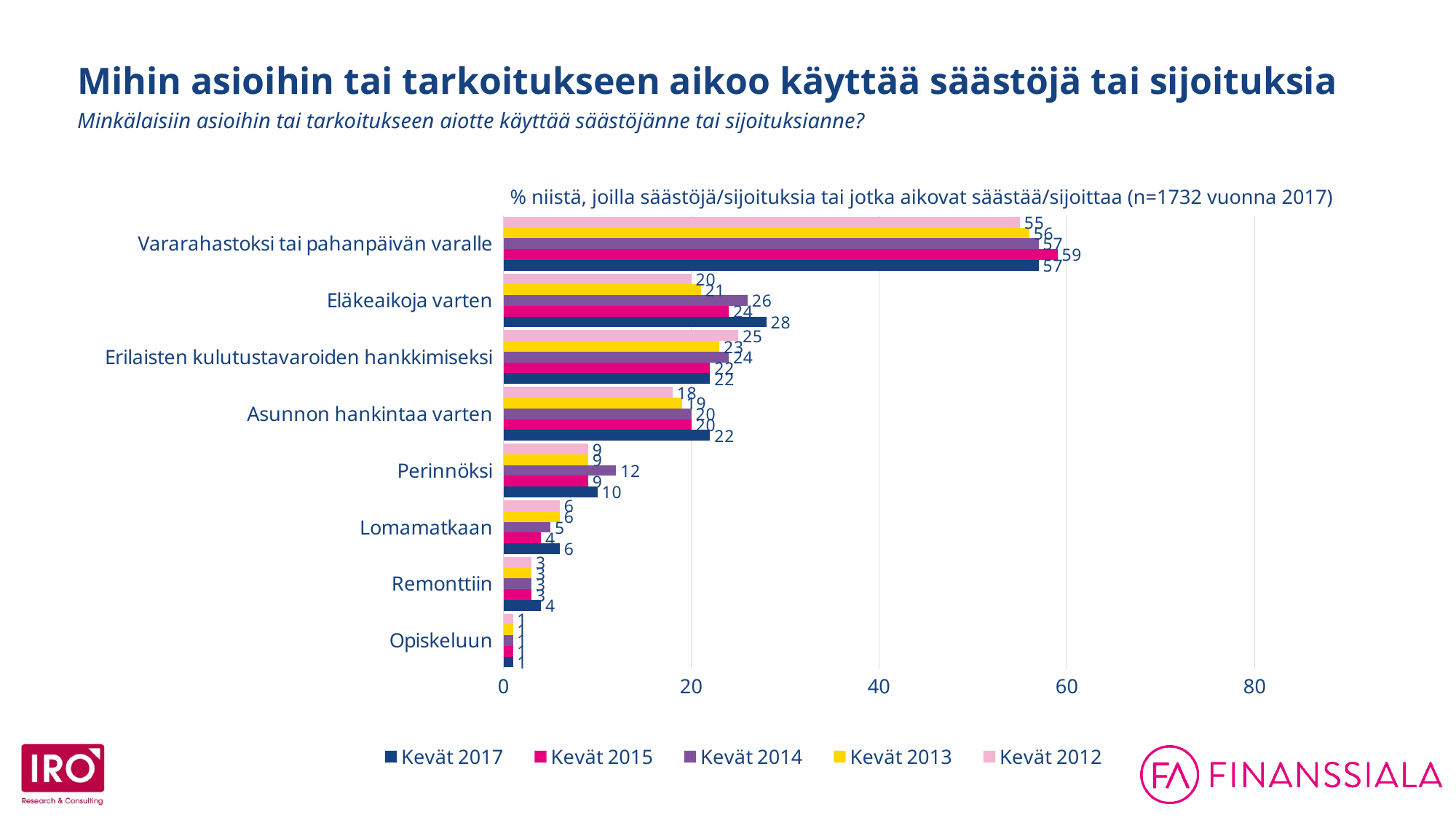
For 'Erilaisten kulutustavaroiden hankkimiseksi', which is larger: the Kevät 2012 value or the Kevät 2017 value? Kevät 2012 Which category has the lowest value in the Kevät 2017 series? Opiskeluun Which series is shown in yellow in the legend? Kevät 2013 Which category has the highest value in the Kevät 2017 series? Vararahastoksi tai pahanpäivän varalle What is the value for 'Perinnöksi' in the Kevät 2014 series? 12 Is the Kevät 2015 value for 'Vararahastoksi tai pahanpäivän varalle' greater or less than 40? greater How many series does the legend list? 5 What kind of chart is shown on the slide? bar chart How many categories are shown on the chart? 8 What is the value for 'Eläkeaikoja varten' in the Kevät 2017 series? 28 What is the value for 'Vararahastoksi tai pahanpäivän varalle' in the Kevät 2015 series? 59 What is the difference between the Kevät 2017 and Kevät 2012 values for 'Eläkeaikoja varten'? 8